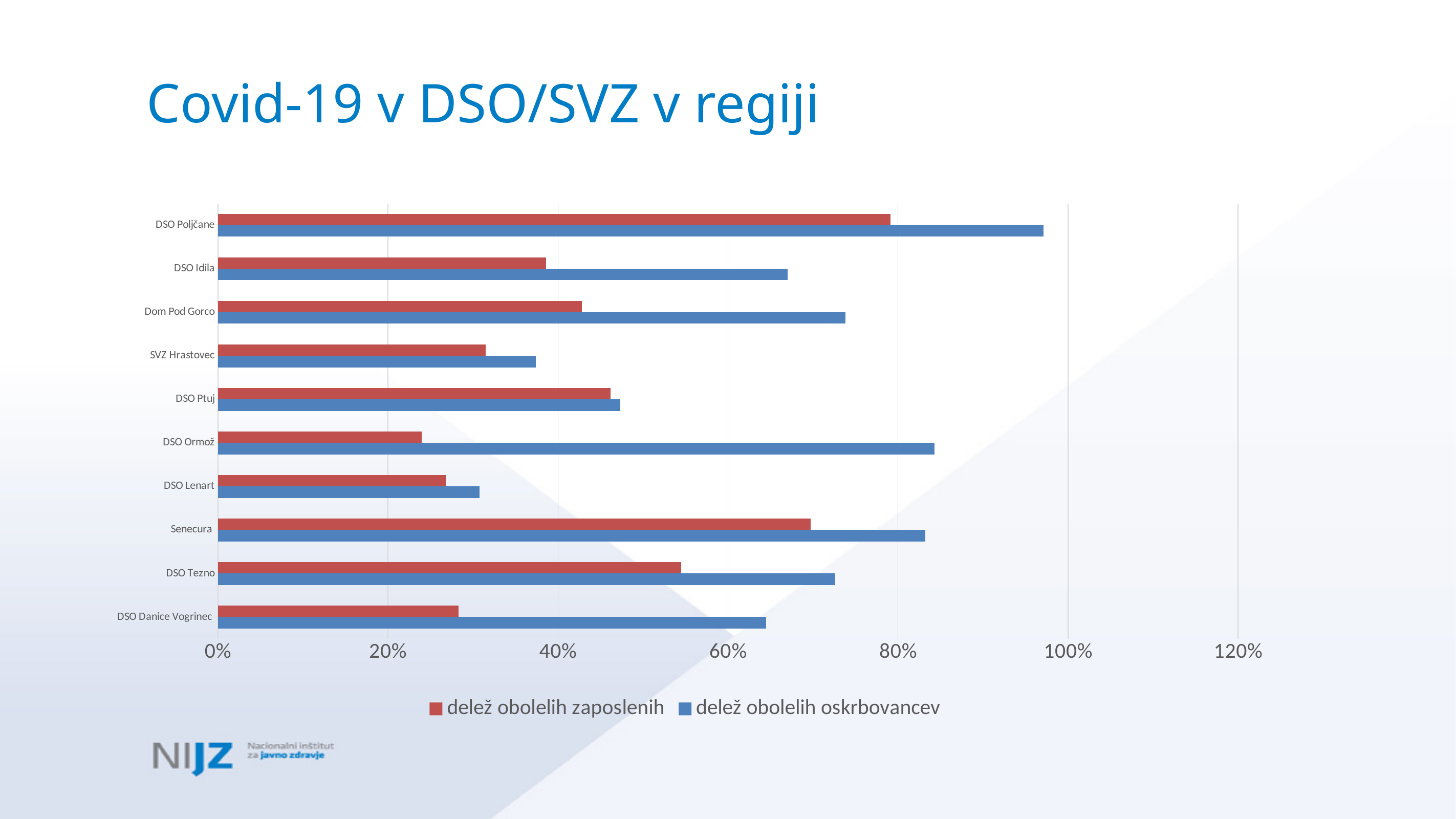
How many institutions (categories) are listed on the chart? 10 Is the 'delež obolelih oskrbovancev' value for DSO Ormož greater or less than 80%? greater What kind of chart is shown on the slide? bar chart Which institution has the highest value for 'delež obolelih oskrbovancev'? DSO Poljčane Which is larger for Senecura: 'delež obolelih zaposlenih' or 'delež obolelih oskrbovancev'? delež obolelih oskrbovancev Is the 'delež obolelih oskrbovancev' value for DSO Danice Vogrinec greater or less than 60%? greater Which institution has the highest value for 'delež obolelih zaposlenih'? DSO Poljčane Which colour represents 'delež obolelih oskrbovancev' in the legend? blue How many series does the legend list? 2 Is the 'delež obolelih zaposlenih' value for DSO Ormož greater or less than 40%? less Which institution has the larger 'delež obolelih zaposlenih' value: DSO Tezno or DSO Idila? DSO Tezno Which institution has the lowest value for 'delež obolelih oskrbovancev'? DSO Lenart